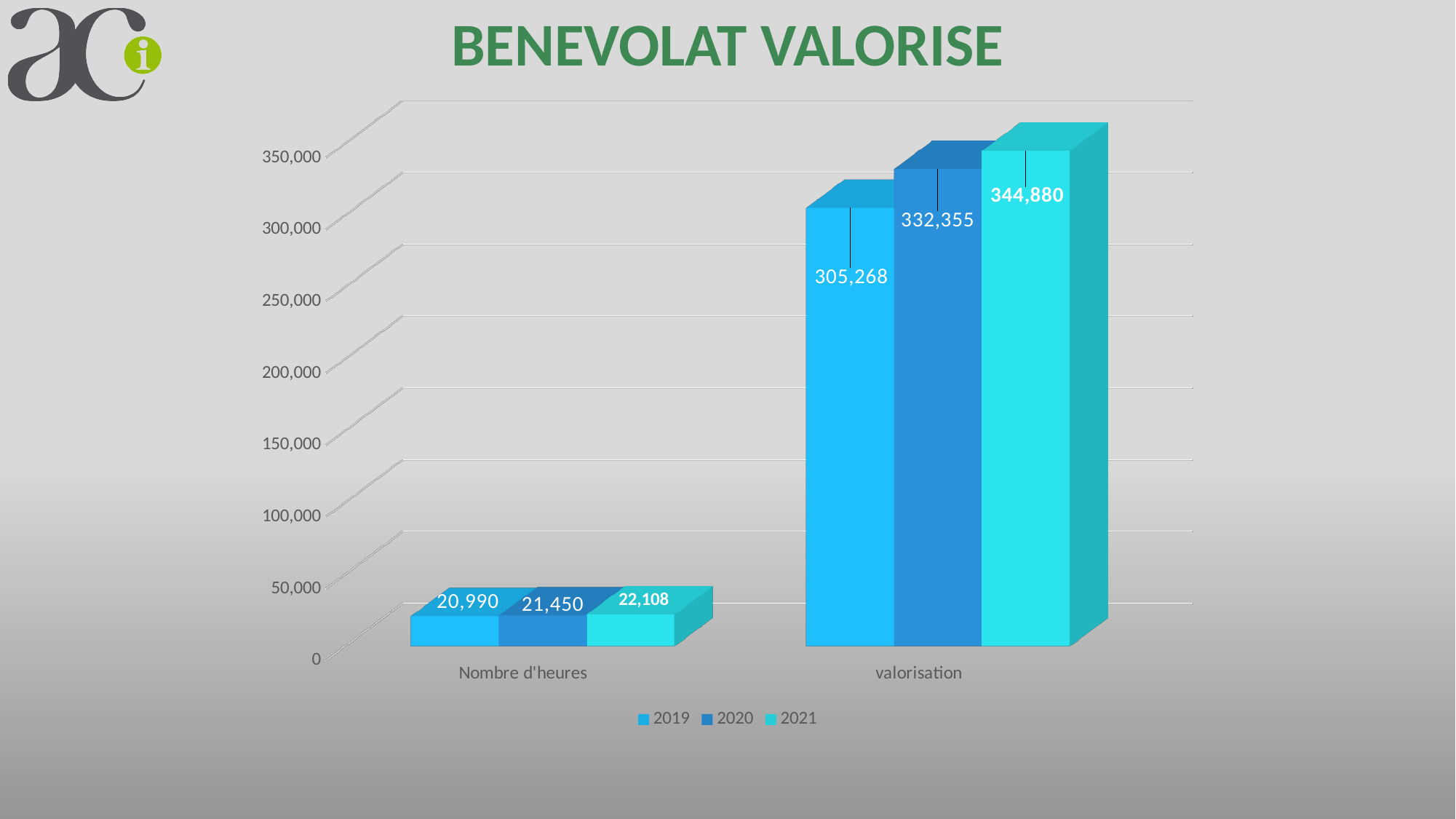
What is the value for 2021 in the Nombre d'heures category? 22,108 What is the value for 2020 in the valorisation category? 332,355 Which is larger: the 2020 value for valorisation or the 2019 value for valorisation? 2020 What is the difference between the 2021 and 2019 values in the valorisation category? 39,612 Which year has the highest value in the valorisation category? 2021 Which year has the lowest value in the Nombre d'heures category? 2019 What is the title of the chart? BENEVOLAT VALORISE What is the difference between the 2020 and 2019 values in the Nombre d'heures category? 460 What kind of chart is shown on the slide? Bar chart What is the value for 2019 in the Nombre d'heures category? 20,990 How many series does the legend list? 3 What is the value for 2021 in the valorisation category? 344,880